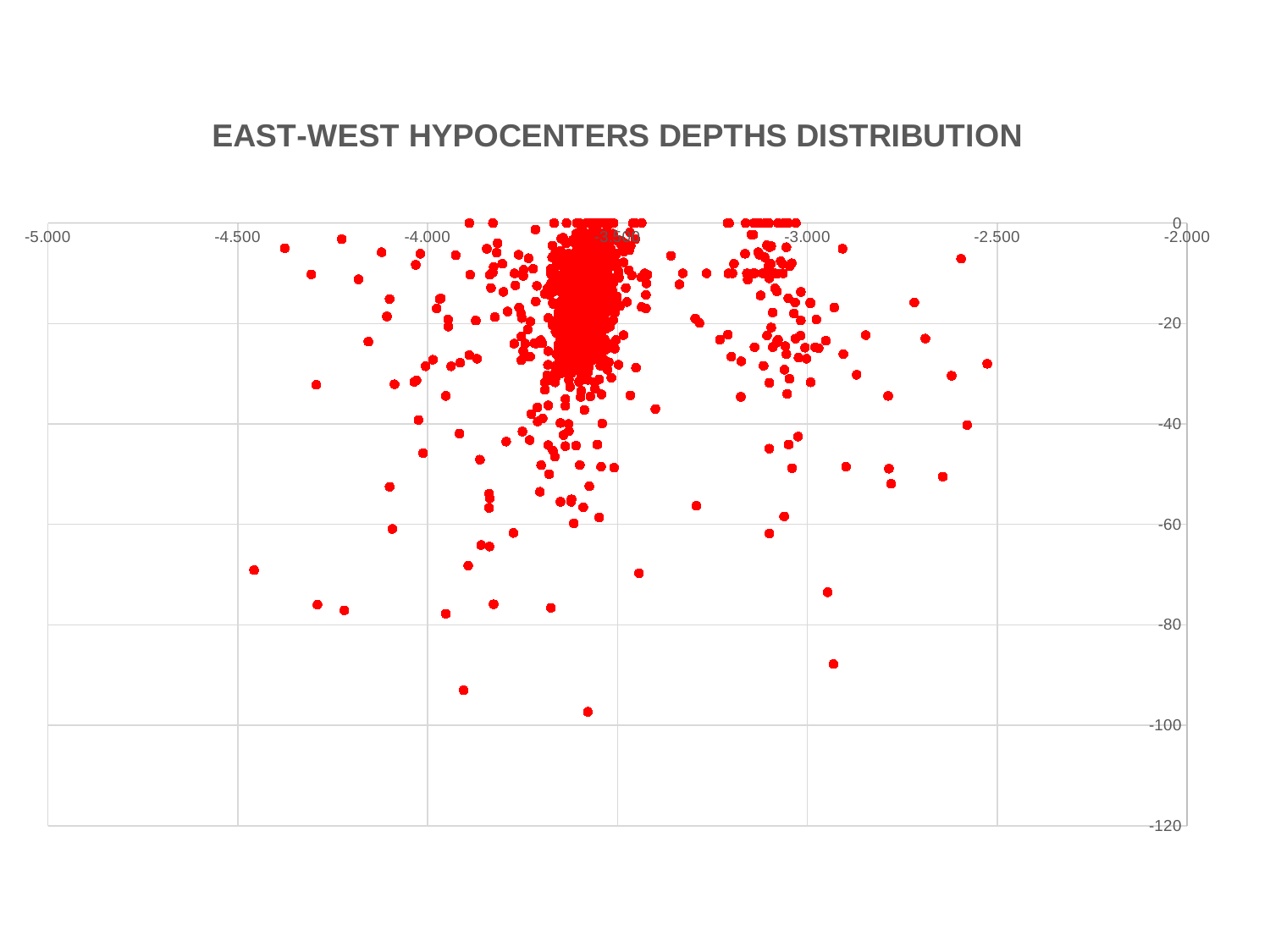
What is the rightmost value labelled on the horizontal axis? -2.000 Is the deepest (lowest) plotted point greater or less than -100 on the vertical axis? greater Is the deepest (lowest) plotted point greater or less than -80 on the vertical axis? less What colour are the plotted points? Red What is the leftmost value labelled on the horizontal axis? -5.000 Around which horizontal-axis value are the plotted points most densely clustered? -3.500 What is the highest value labelled on the vertical axis? 0 What is the lowest value labelled on the vertical axis? -120 How many tick labels are shown on the horizontal axis? 7 What kind of chart is shown on the slide? Scatter chart How many tick labels are shown on the vertical axis? 7 What is the title of the chart? EAST-WEST HYPOCENTERS DEPTHS DISTRIBUTION